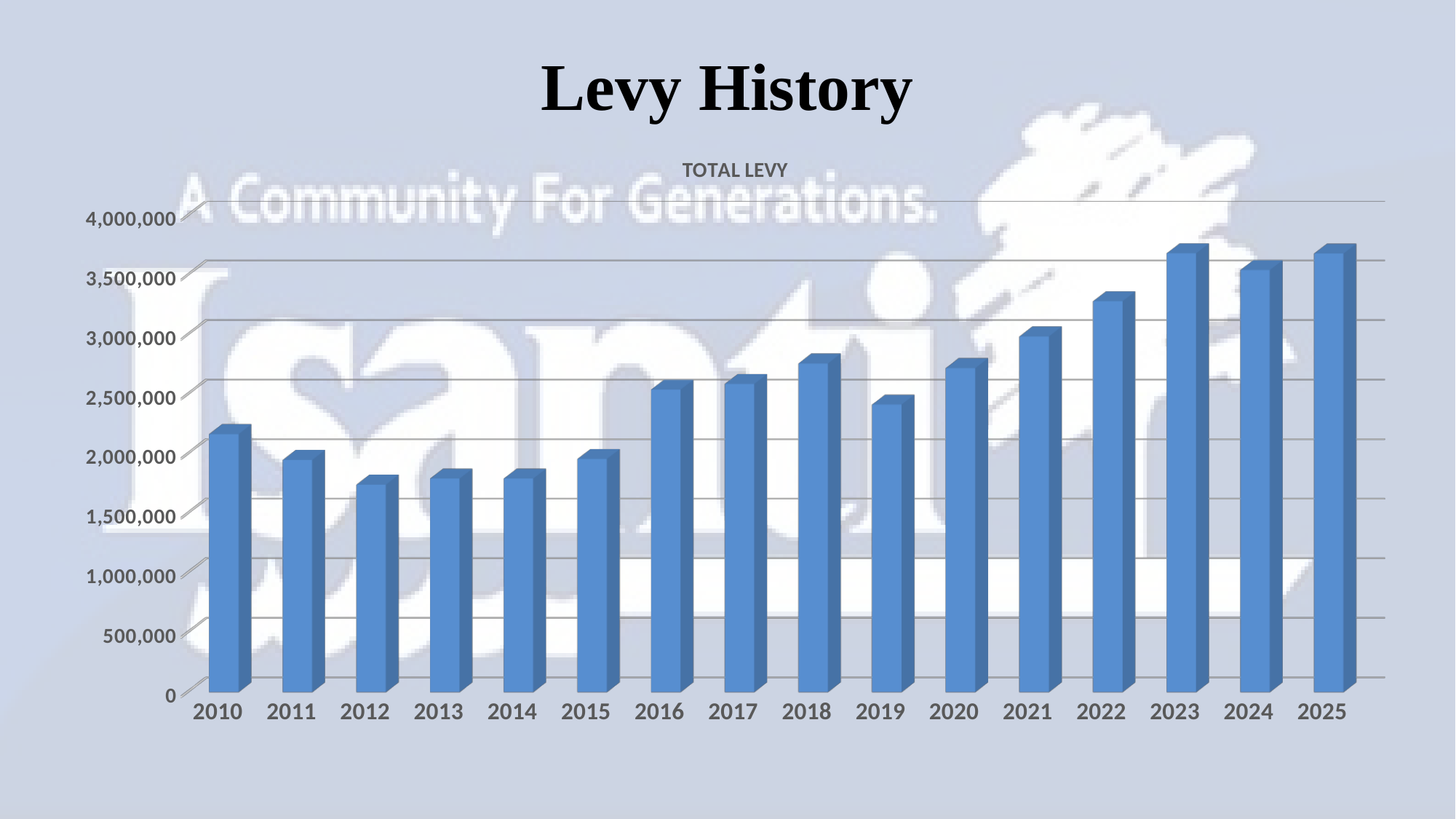
Which year has the larger value, 2019 or 2022? 2022 How many years are shown on the x axis of the chart? 16 Overall, do the values rise or fall from 2010 to 2025? Rise What kind of chart is shown on the slide? Bar chart Which year has the larger value, 2010 or 2012? 2010 Is the value for 2012 greater or less than 2,000,000? less Is the value for 2018 greater or less than 2,500,000? greater What is the highest value labelled on the vertical axis? 4,000,000 Is the value for 2023 greater or less than 3,500,000? greater What is the title printed above the chart's plot area? TOTAL LEVY